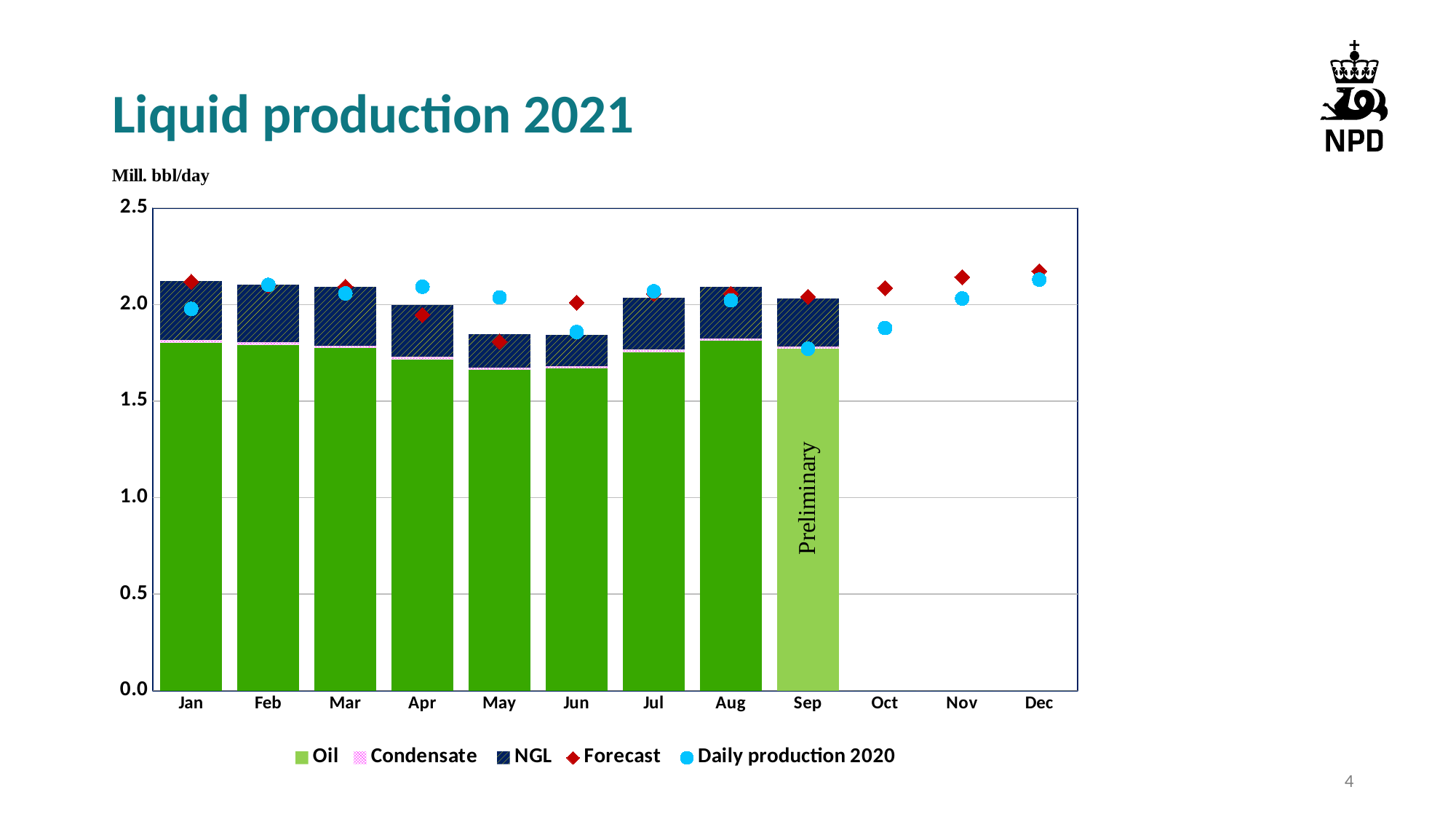
Do the Forecast values rise or fall from Oct to Dec? Rise Is the total liquid production bar for Jan greater or less than 2.0 Mill. bbl/day? greater Is the total liquid production bar for May greater or less than 2.0 Mill. bbl/day? less Which month's bar is marked as 'Preliminary'? Sep Which is larger, the Forecast value for Oct or for Dec? Dec What kind of chart is shown on the slide? Stacked bar chart with overlaid markers Which is larger, the total stacked bar for Jan or for May? Jan How many months are labelled on the x axis? 12 How many series does the legend list? 5 Is the Daily production 2020 value for Oct greater or less than 2.0 Mill. bbl/day? less How many months have a stacked bar plotted? 9